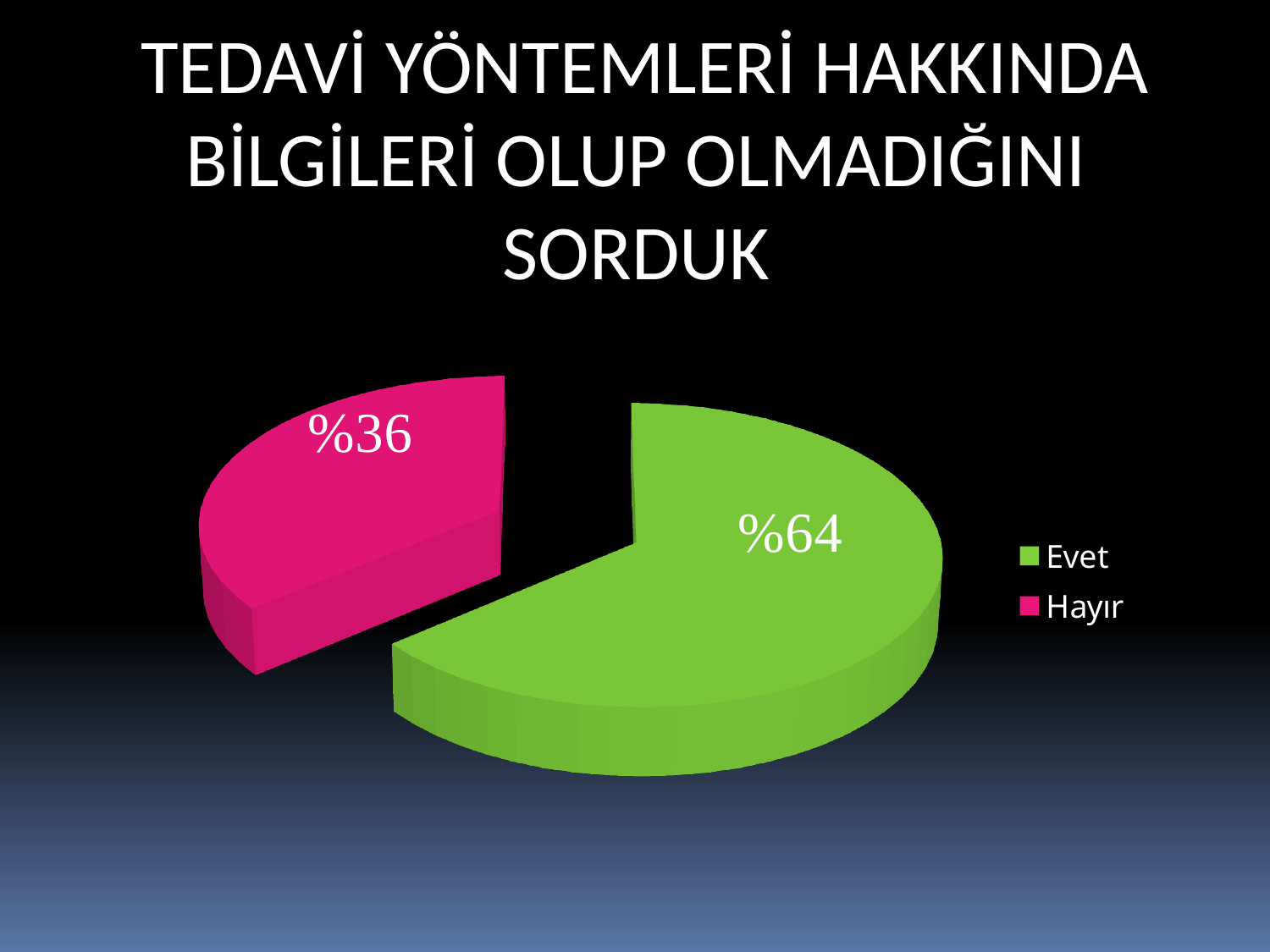
Which category has the largest slice of the pie? Evet Which is larger, the value for Evet or the value for Hayır? Evet How many slices does the pie chart have? 2 What colour is the Evet slice? green What colour is the Hayır slice? pink What kind of chart is shown on the slide? pie chart What is the value shown for Hayır? %36 What is the difference between the Evet and Hayır values? %28 Which category has the smallest slice of the pie? Hayır What share of the pie does the Hayır slice represent? %36 What is the value shown for Evet? %64 How many entries does the legend list? 2